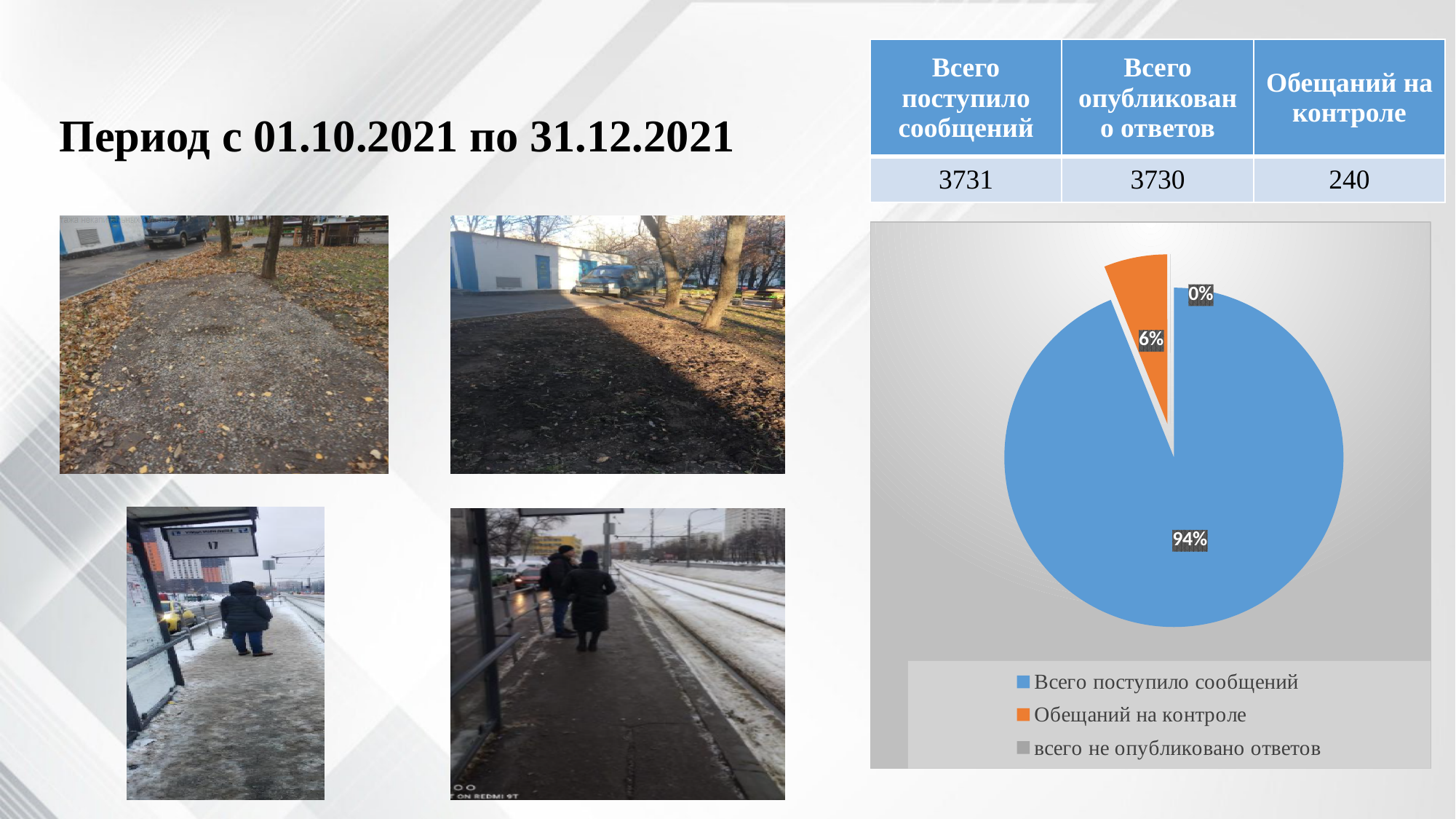
What share of the pie chart does "Всего поступило сообщений" take? 94% How many categories does the pie chart's legend list? 3 Which is larger in the pie chart: "Обещаний на контроле" or "всего не опубликовано ответов"? Обещаний на контроле What is the difference in percentage points between the "Всего поступило сообщений" slice and the "Обещаний на контроле" slice? 88% What colour is the "Обещаний на контроле" slice in the pie chart? orange What share of the pie chart does "Обещаний на контроле" take? 6% Which category has the smallest slice in the pie chart? всего не опубликовано ответов Which category has the largest slice in the pie chart? Всего поступило сообщений What share of the pie chart does "всего не опубликовано ответов" take? 0% What kind of chart is shown on the right side of the slide? pie chart What colour is the "Всего поступило сообщений" slice in the pie chart? blue